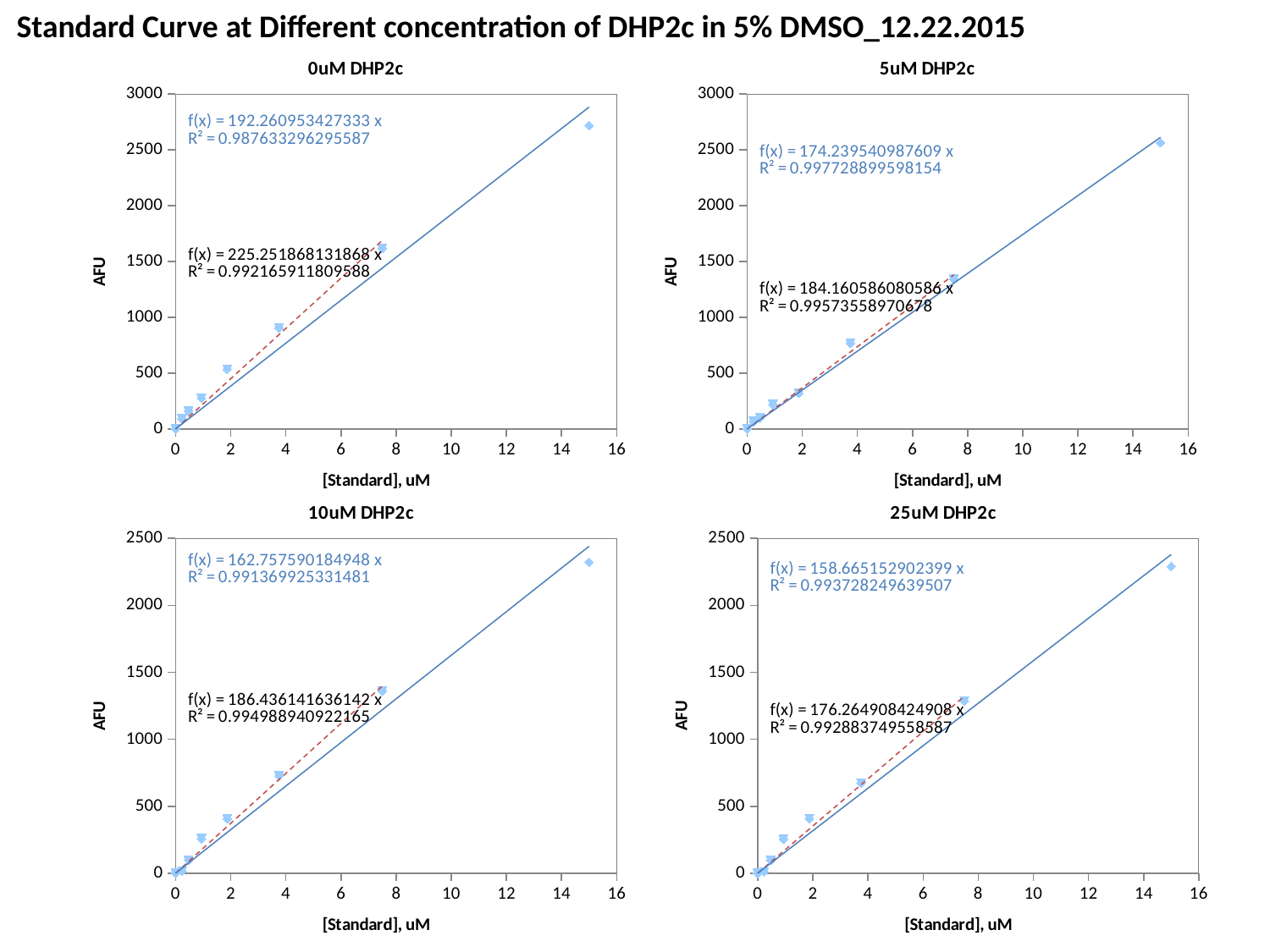
In the 10uM DHP2c chart, is the AFU value at about 7.5 uM standard greater or less than 1500? less Which of the four charts has the highest blue trendline slope? 0uM DHP2c In the 0uM DHP2c chart, what is the slope of the blue trendline equation f(x)? 192.260953427333 In the 25uM DHP2c chart, what is the slope of the blue trendline equation f(x)? 158.665152902399 In the 25uM DHP2c chart, does AFU rise or fall as the standard concentration increases? rise In the 0uM DHP2c chart, is the AFU value at 15 uM standard greater or less than 2500? greater In the 5uM DHP2c chart, what is the R² value printed for the blue trendline? 0.997728899598154 What is the y-axis label on each of the four charts? AFU How many charts are shown on the slide? 4 What kind of chart is used in the four panels on this slide? Scatter chart with trendlines In the 10uM DHP2c chart, what is the slope of the black (dashed red line) trendline equation f(x)? 186.436141636142 Which of the four charts has the lowest blue trendline slope? 25uM DHP2c